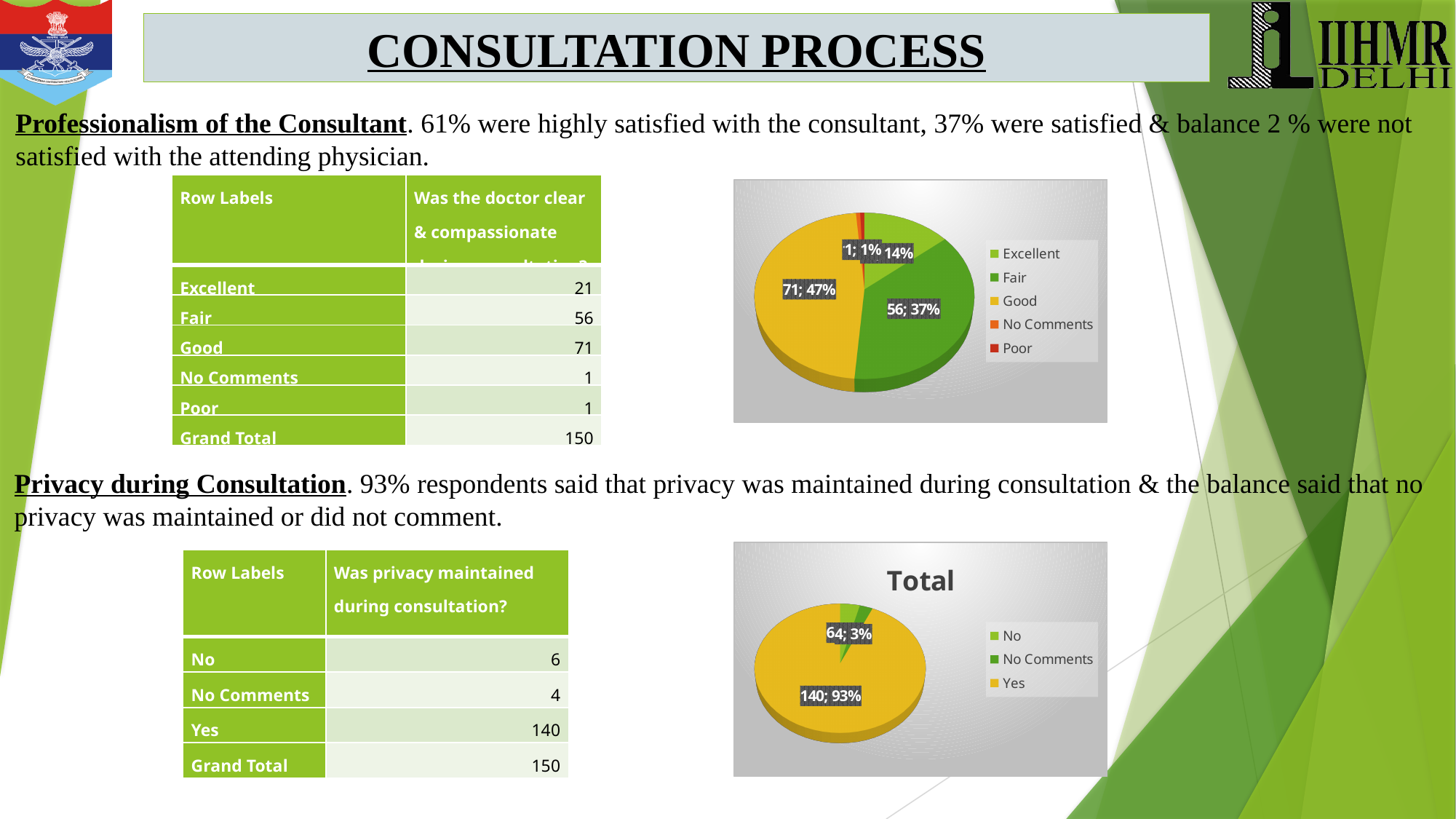
In the lower pie chart titled Total, what share of the pie does Yes represent? 93% In the upper pie chart, how many categories does the legend list? 5 What type of chart is the upper chart on the slide? Pie chart In the lower pie chart titled Total, what value is shown for Yes? 140 In the upper pie chart, what share of the pie does Good represent? 47% In the upper pie chart, which category has the largest slice? Good In the upper pie chart, what share of the pie does Fair represent? 37% What is the title of the lower pie chart? Total In the upper pie chart, what is the difference between the values for Good and Fair? 15 In the upper pie chart, which is larger, Good or Fair? Good In the upper pie chart, what value is shown for Good? 71 In the lower pie chart titled Total, how many categories does the legend list? 3